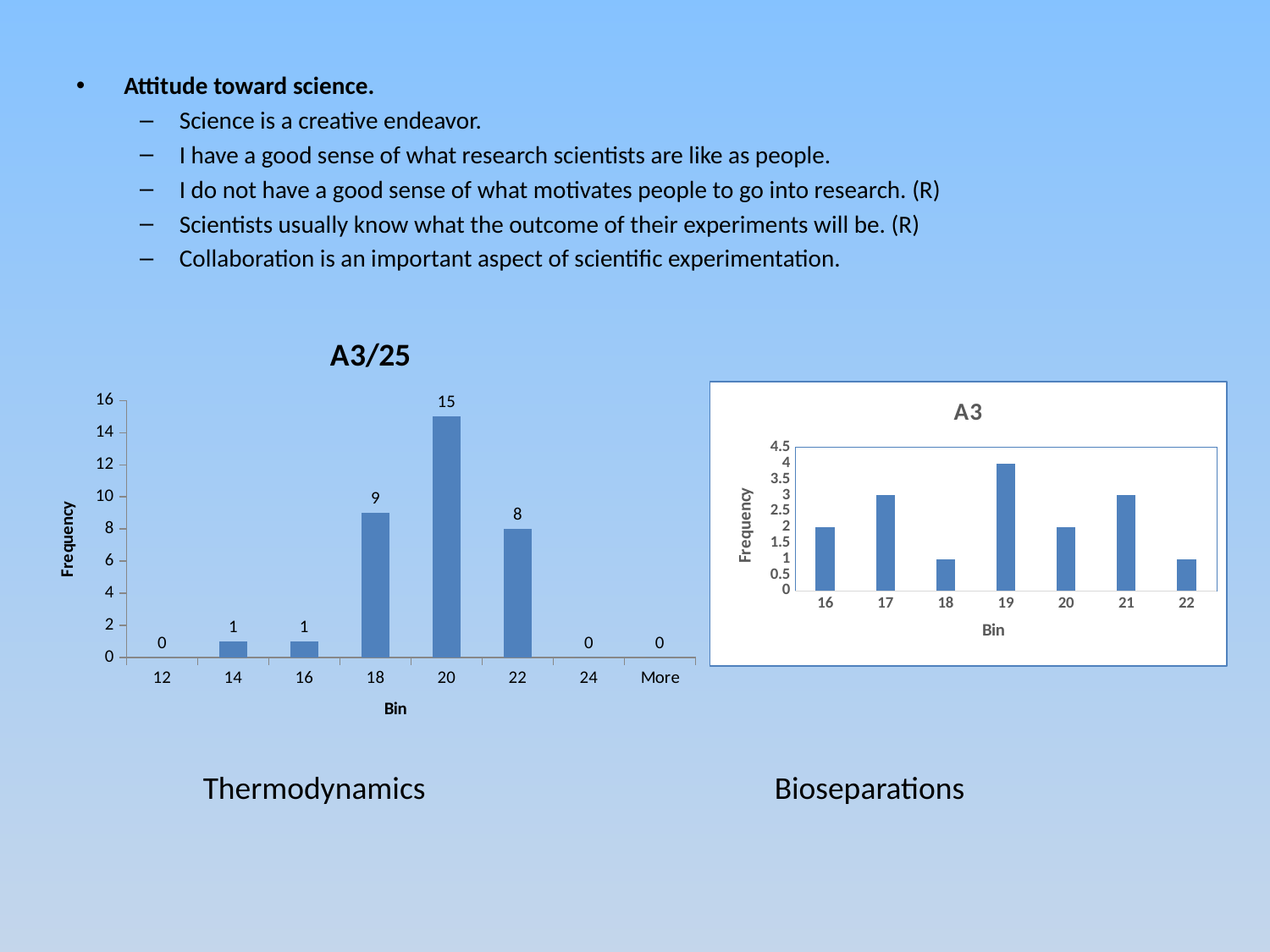
In the A3 chart on the right, which bin has the highest frequency? 19 How many bins are shown on the x axis of the A3 chart on the right? 7 What is the y-axis label of the A3 chart on the right? Frequency In the A3/25 chart, which bin has the highest frequency? 20 What kind of chart is the A3/25 chart? bar chart In the A3/25 chart, what is the difference between the frequencies for bin 20 and bin 22? 7 In the A3 chart on the right, what is the frequency for bin 19? 4 In the A3 chart on the right, is the frequency for bin 17 greater or less than 2? greater In the A3/25 chart, which has the larger frequency, bin 18 or bin 22? 18 In the A3/25 chart, what is the frequency for bin 18? 9 In the A3/25 chart, what is the frequency for bin 20? 15 How many bins are shown on the x axis of the A3/25 chart? 8